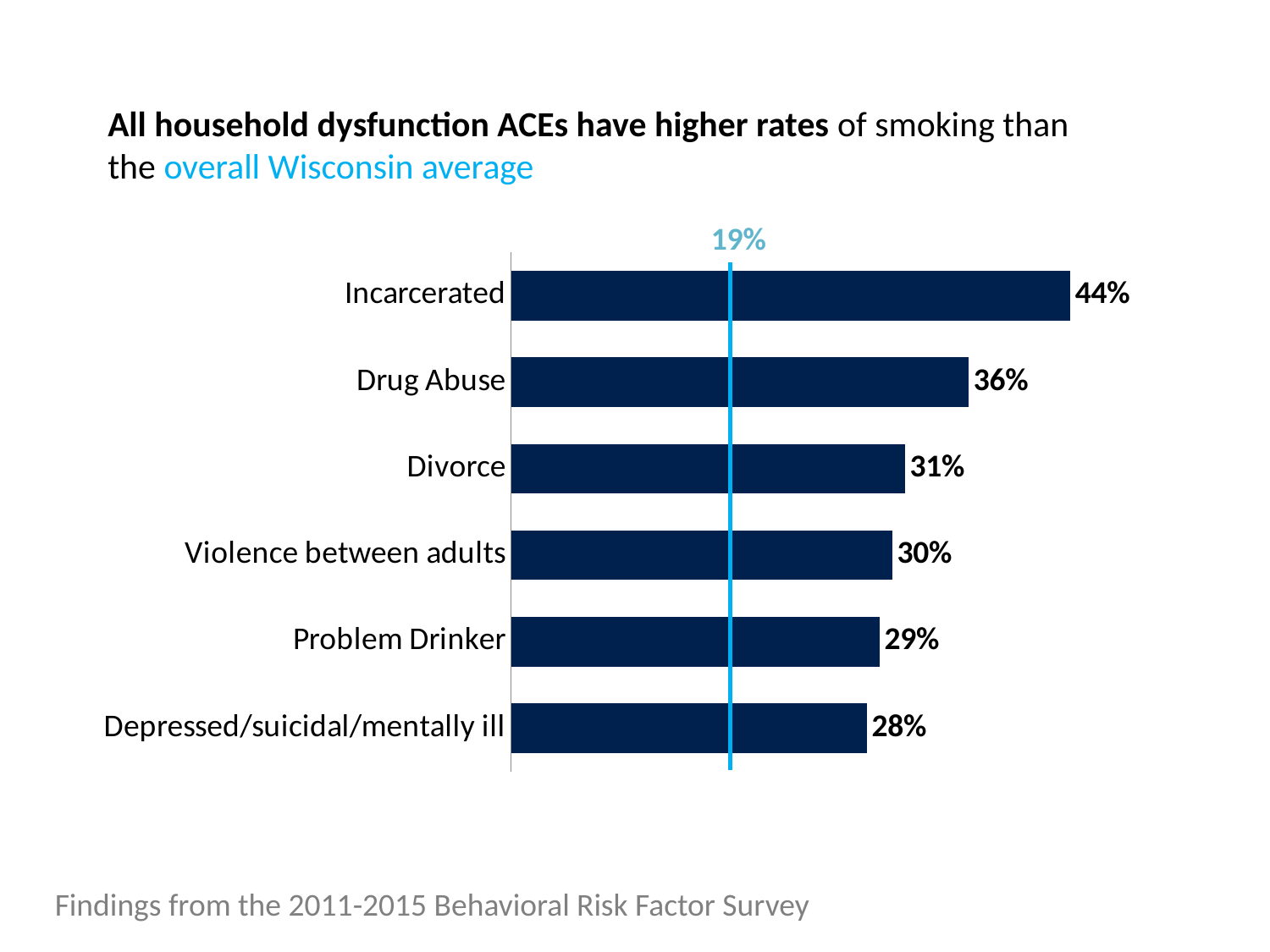
What is the smoking rate for the Problem Drinker category? 29% What type of chart is shown on the slide? Bar chart Which category has the highest smoking rate? Incarcerated What is the smoking rate for the Drug Abuse category? 36% Which has a higher smoking rate, Divorce or Violence between adults? Divorce What value does the vertical blue line marking the overall Wisconsin average represent? 19% Which category has the lowest smoking rate? Depressed/suicidal/mentally ill What is the difference between the smoking rates for Incarcerated and Drug Abuse? 8% What is the smoking rate for the Incarcerated category? 44% How many categories are shown in the bar chart? 6 What survey is cited as the source of the findings at the bottom of the slide? 2011-2015 Behavioral Risk Factor Survey What is the difference between the smoking rate for Divorce and the overall Wisconsin average shown by the vertical line? 12%